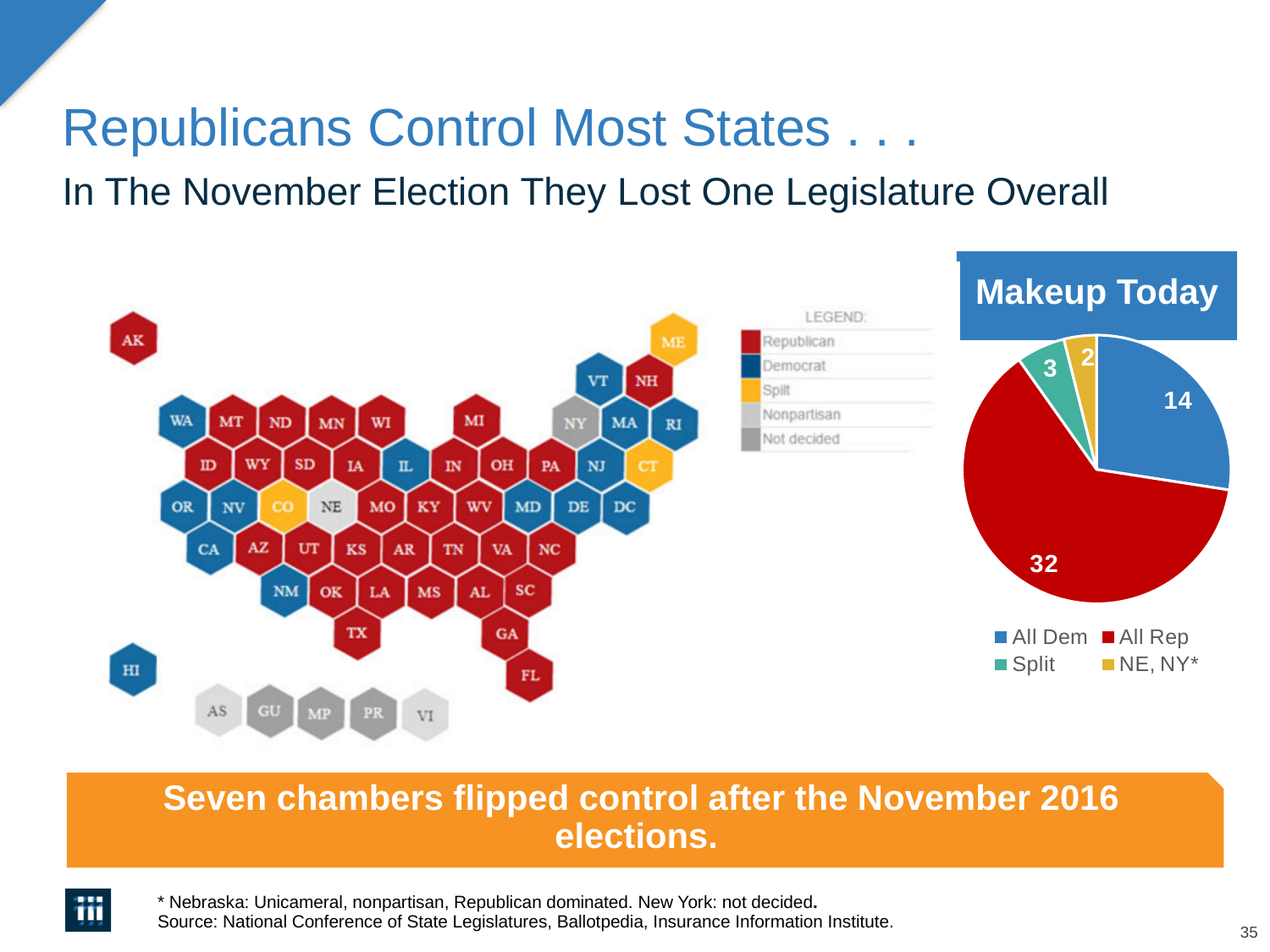
In the "Makeup Today" pie chart, what is the value for NE, NY*? 2 In the "Makeup Today" pie chart, which is larger, All Dem or Split? All Dem In the "Makeup Today" pie chart, which category has the largest slice? All Rep In the "Makeup Today" pie chart, what is the difference between the All Rep and All Dem values? 18 What type of chart is the "Makeup Today" chart? Pie chart In the "Makeup Today" pie chart, what is the value for Split? 3 In the "Makeup Today" pie chart, what is the value for All Dem? 14 In the "Makeup Today" pie chart, which category has the smallest slice? NE, NY* In the "Makeup Today" pie chart, what colour is the All Rep slice? Red In the "Makeup Today" pie chart, what is the value for All Rep? 32 In the "Makeup Today" pie chart, what is the total of all the slices? 51 How many categories does the legend of the "Makeup Today" pie chart list? 4